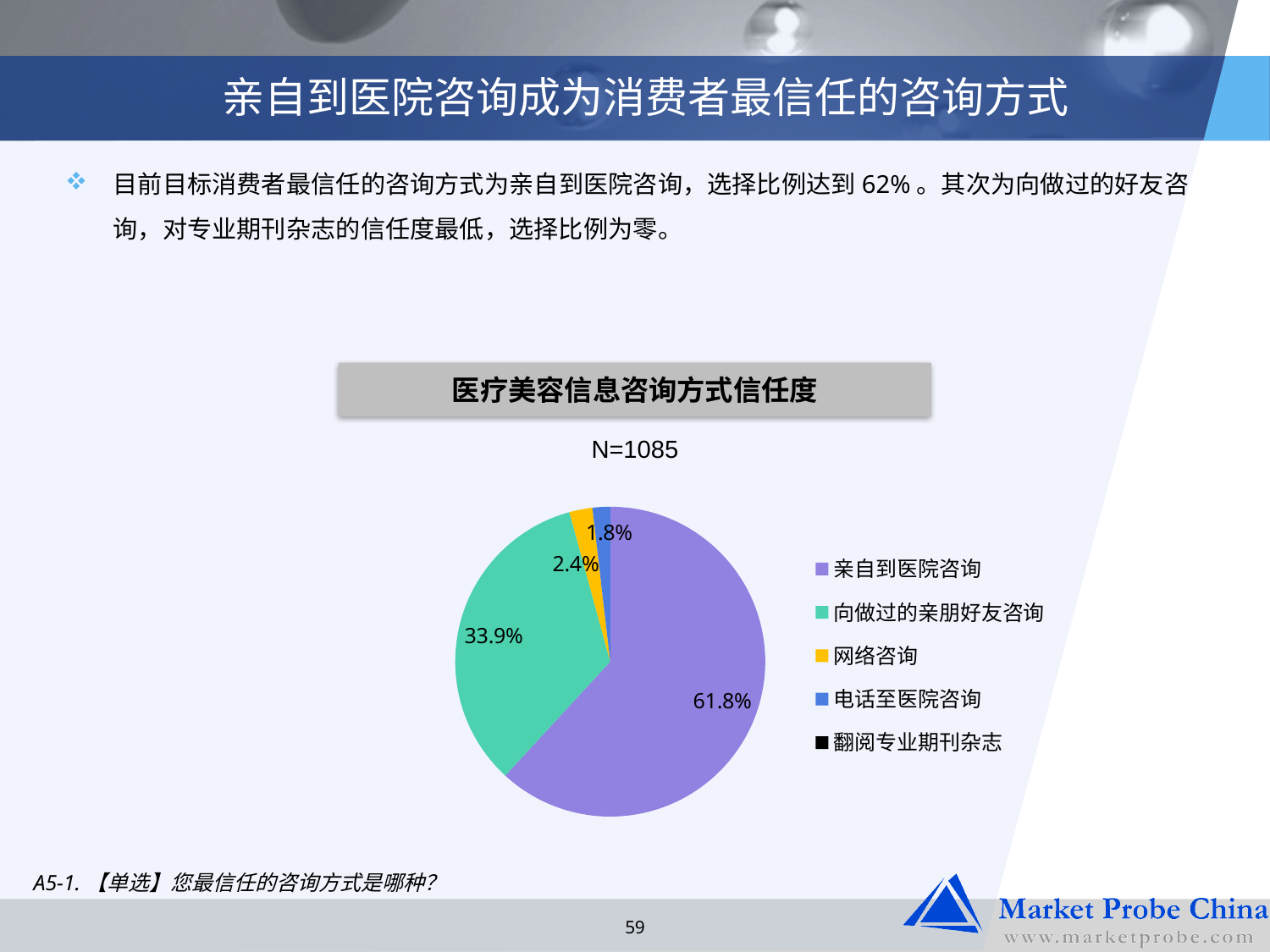
What is the combined share of 网络咨询 and 电话至医院咨询? 4.2% Which is larger, the share for 网络咨询 or the share for 电话至医院咨询? 网络咨询 What is the difference between the shares for 亲自到医院咨询 and 向做过的亲朋好友咨询? 27.9% What is the title of the chart? 医疗美容信息咨询方式信任度 What is the sample size (N) shown above the chart? N=1085 What share of the pie is 向做过的亲朋好友咨询? 33.9% What share of the pie is 亲自到医院咨询? 61.8% Which category has the largest slice of the pie? 亲自到医院咨询 What kind of chart is shown on the slide? pie chart What share of the pie is 网络咨询? 2.4% How many entries does the legend list? 5 What share of the pie is 电话至医院咨询? 1.8%